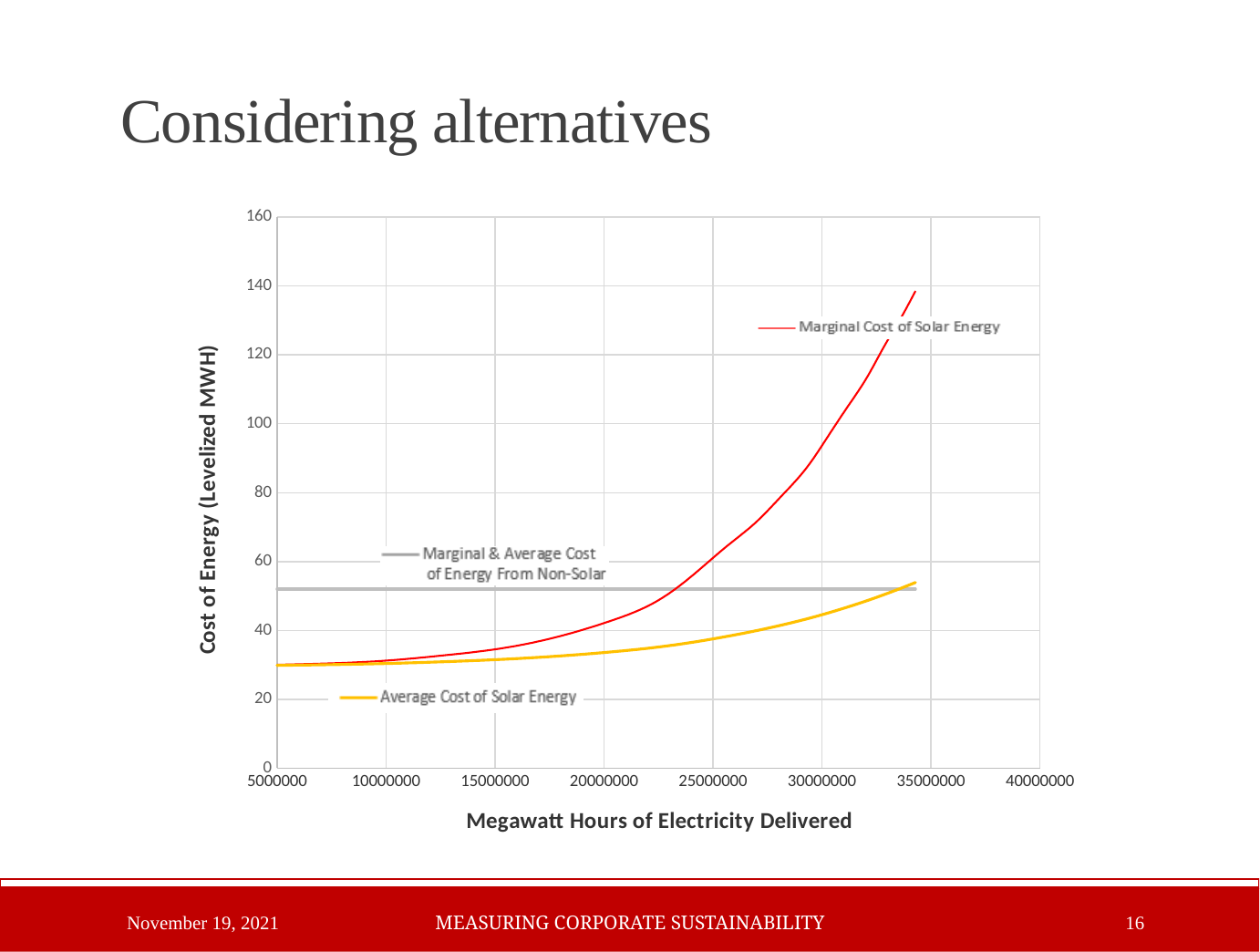
Which series stays flat across the whole x axis? Marginal & Average Cost of Energy From Non-Solar At 30000000 megawatt hours, which is larger: the Marginal Cost of Solar Energy or the Average Cost of Solar Energy? Marginal Cost of Solar Energy What is the title of the x axis? Megawatt Hours of Electricity Delivered Is the Marginal & Average Cost of Energy From Non-Solar greater or less than 60? less At 10000000 megawatt hours, is the Average Cost of Solar Energy greater or less than 40? less What kind of chart is shown on the slide? line chart How many series are plotted on the chart? 3 At 30000000 megawatt hours, is the Marginal Cost of Solar Energy greater or less than 60? greater Which series reaches the highest value on the chart? Marginal Cost of Solar Energy Does the Marginal Cost of Solar Energy rise or fall as Megawatt Hours of Electricity Delivered increases? rise Does the Average Cost of Solar Energy rise or fall along the x axis? rise